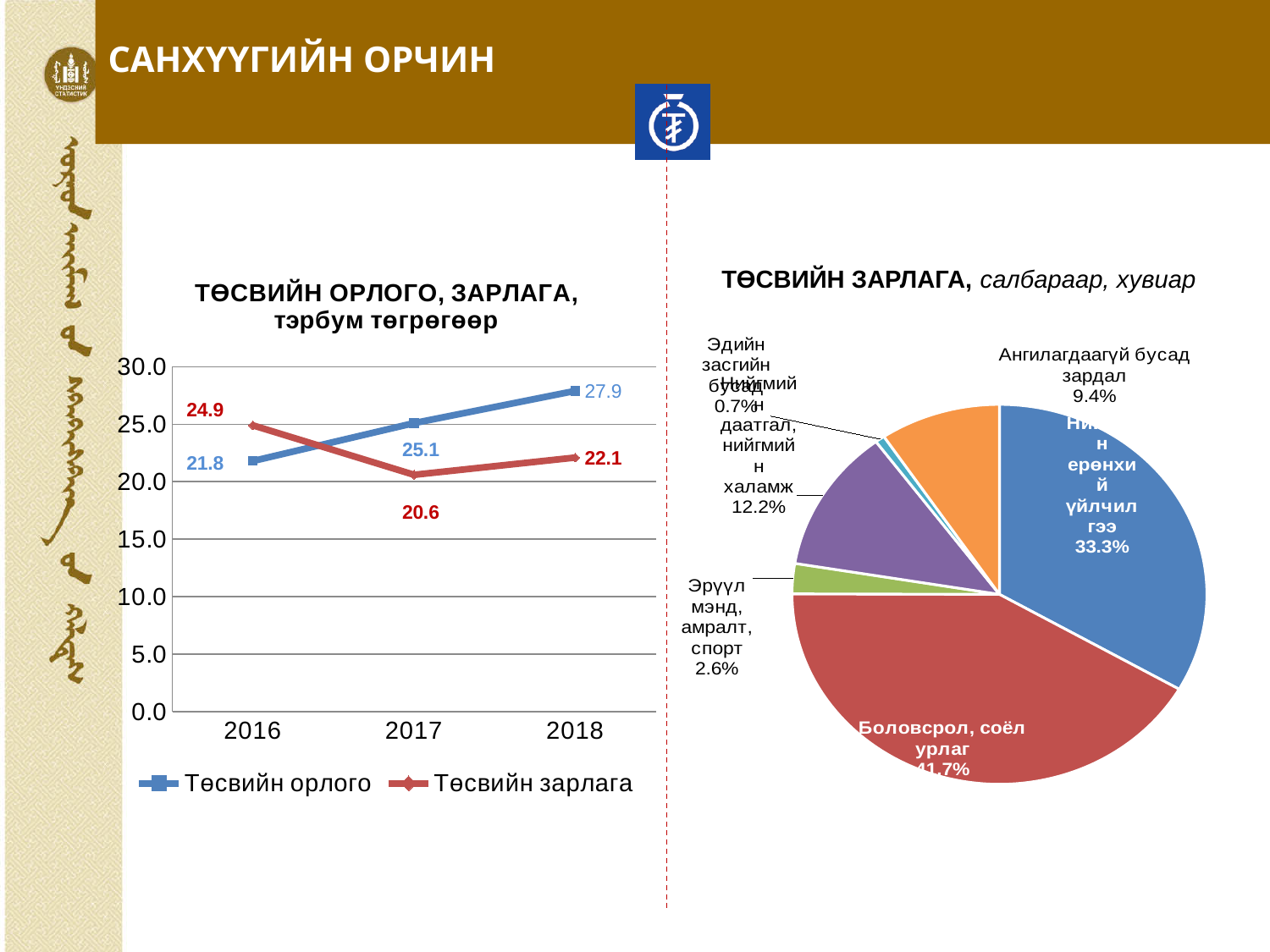
In the line chart 'ТӨСВИЙН ОРЛОГО, ЗАРЛАГА', in which year is Төсвийн зарлага highest? 2016 In the line chart 'ТӨСВИЙН ОРЛОГО, ЗАРЛАГА', what is the value of Төсвийн зарлага in 2017? 20.6 In the pie chart 'ТӨСВИЙН ЗАРЛАГА, салбараар, хувиар', what share does Эрүүл мэнд, амралт, спорт have? 2.6% In the line chart 'ТӨСВИЙН ОРЛОГО, ЗАРЛАГА', which is larger in 2016, Төсвийн орлого or Төсвийн зарлага? Төсвийн зарлага How many series does the legend of the line chart 'ТӨСВИЙН ОРЛОГО, ЗАРЛАГА' list? 2 In the line chart 'ТӨСВИЙН ОРЛОГО, ЗАРЛАГА', does Төсвийн орлого rise or fall from 2016 to 2018? rise How many slices does the pie chart 'ТӨСВИЙН ЗАРЛАГА, салбараар, хувиар' have? 6 In the pie chart 'ТӨСВИЙН ЗАРЛАГА, салбараар, хувиар', what share does Боловсрол, соёл урлаг have? 41.7% In the line chart 'ТӨСВИЙН ОРЛОГО, ЗАРЛАГА', in which year is Төсвийн орлого lowest? 2016 In the line chart 'ТӨСВИЙН ОРЛОГО, ЗАРЛАГА', what is the value of Төсвийн орлого in 2018? 27.9 What kind of chart is 'ТӨСВИЙН ЗАРЛАГА, салбараар, хувиар'? pie chart In the line chart 'ТӨСВИЙН ОРЛОГО, ЗАРЛАГА', what is the difference between Төсвийн орлого and Төсвийн зарлага in 2018? 5.8